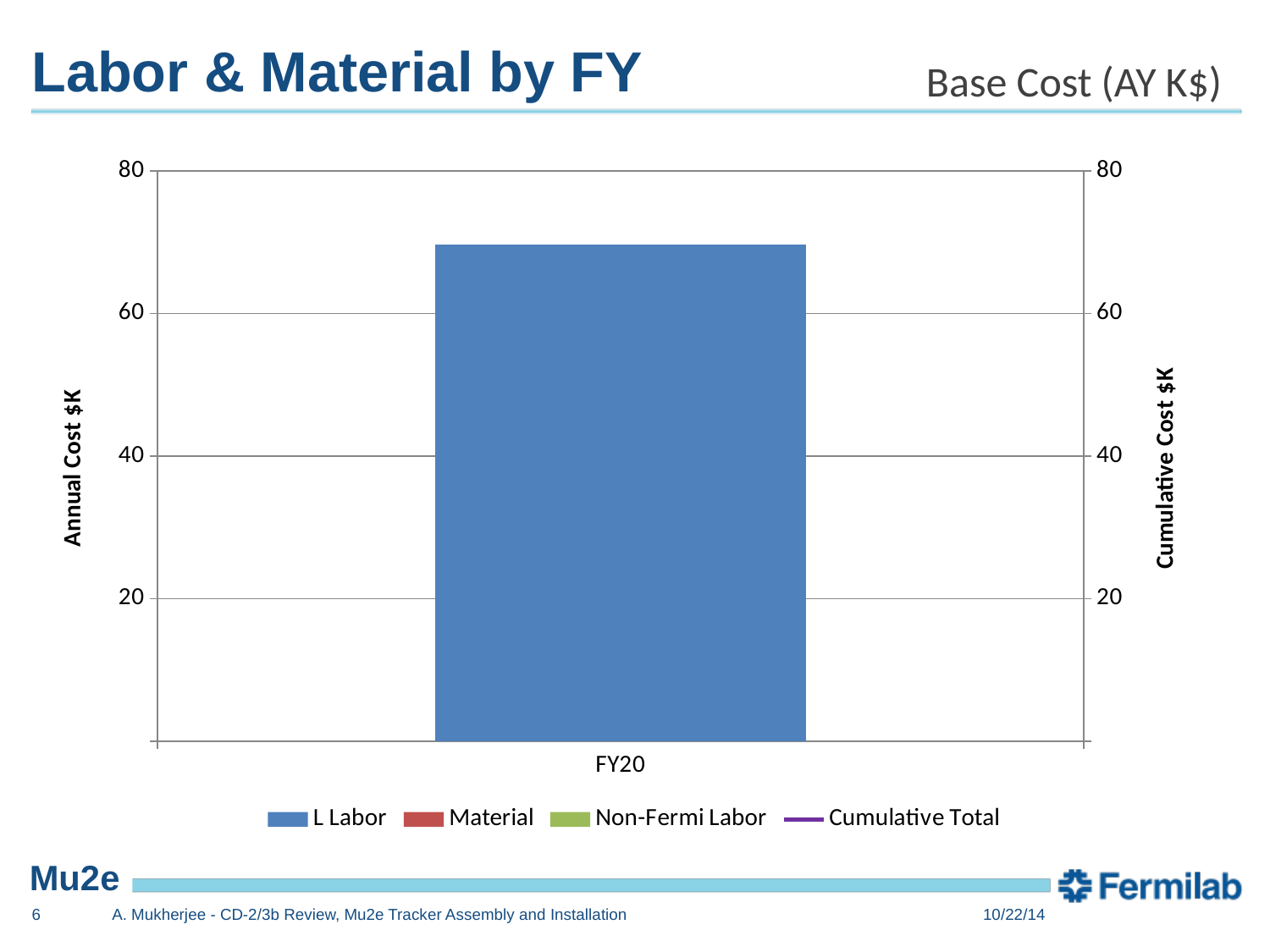
Is the L Labor value for FY20 greater or less than 40? greater Is the L Labor value for FY20 greater or less than 60? greater How many series does the legend list? 4 What kind of chart is shown on the slide? bar chart Is the L Labor value for FY20 greater or less than 80? less How many fiscal-year categories are shown on the x axis? 1 Which category label appears on the x axis? FY20 What is the title of the left vertical axis? Annual Cost $K